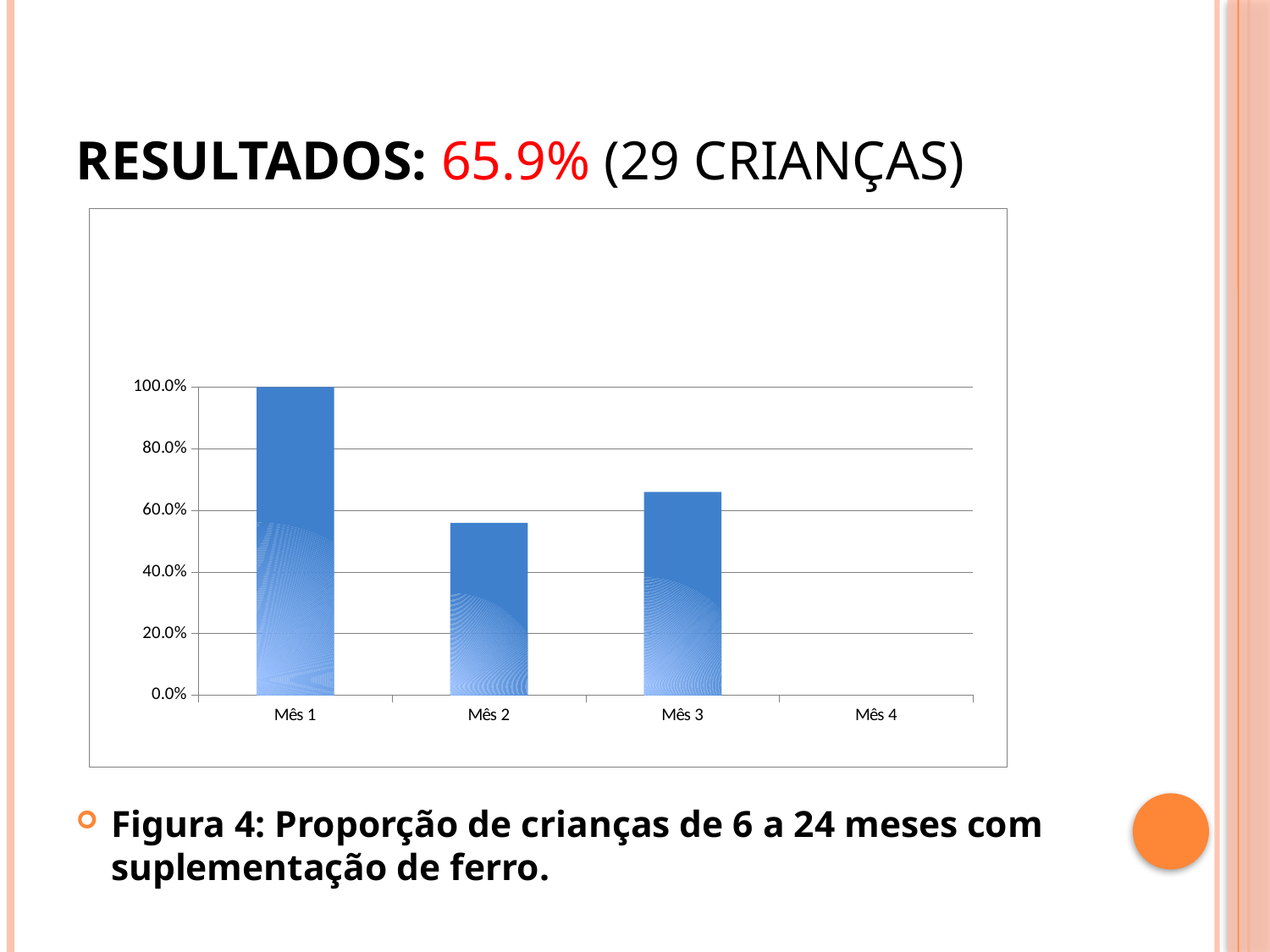
Is the value for Mês 3 greater or less than 80.0%? less Is the value for Mês 3 greater or less than 60.0%? greater Which month has the highest value? Mês 1 Is the value for Mês 2 greater or less than 40.0%? greater Which is larger, the value for Mês 2 or the value for Mês 3? Mês 3 What is the highest tick value shown on the y axis? 100.0% How many categories are shown on the x axis? 4 Among Mês 1, Mês 2 and Mês 3, which has the lowest value? Mês 2 What kind of chart is shown on the slide? bar chart What is the value for Mês 1? 100.0% How many bars are visible in the chart? 3